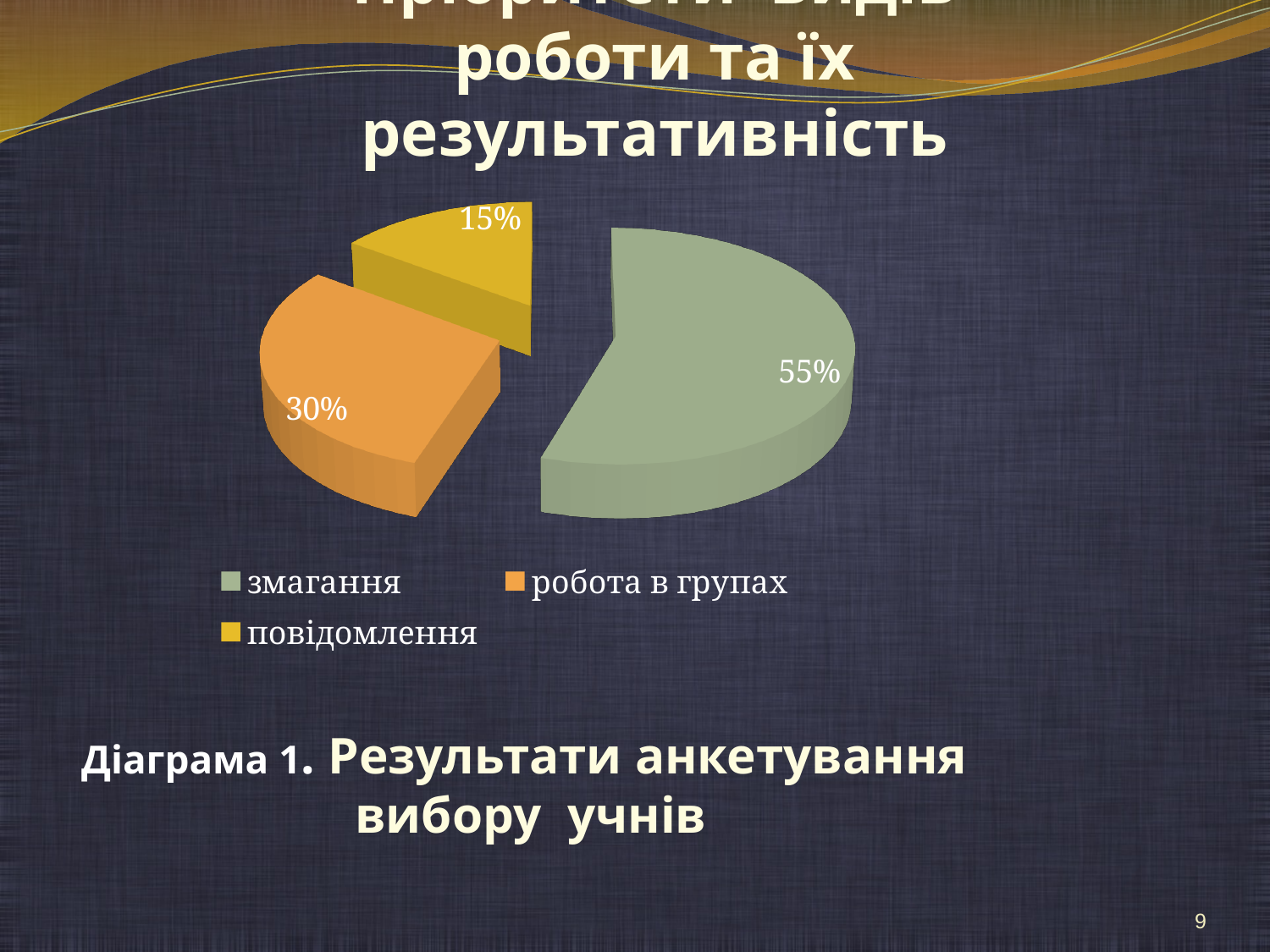
How many categories does the pie chart have? 3 What share of the pie does "повідомлення" have? 15% Which category is shown in yellow? повідомлення Which is larger, the share of "робота в групах" or the share of "повідомлення"? робота в групах What share of the pie does "робота в групах" have? 30% Which category has the smallest slice of the pie? повідомлення Which category has the largest slice of the pie? змагання What is the difference between the shares of "змагання" and "робота в групах"? 25% What is the difference between the shares of "робота в групах" and "повідомлення"? 15% What kind of chart is shown on the slide? pie chart Which colour represents "робота в групах" in the legend? orange What share of the pie does "змагання" have? 55%